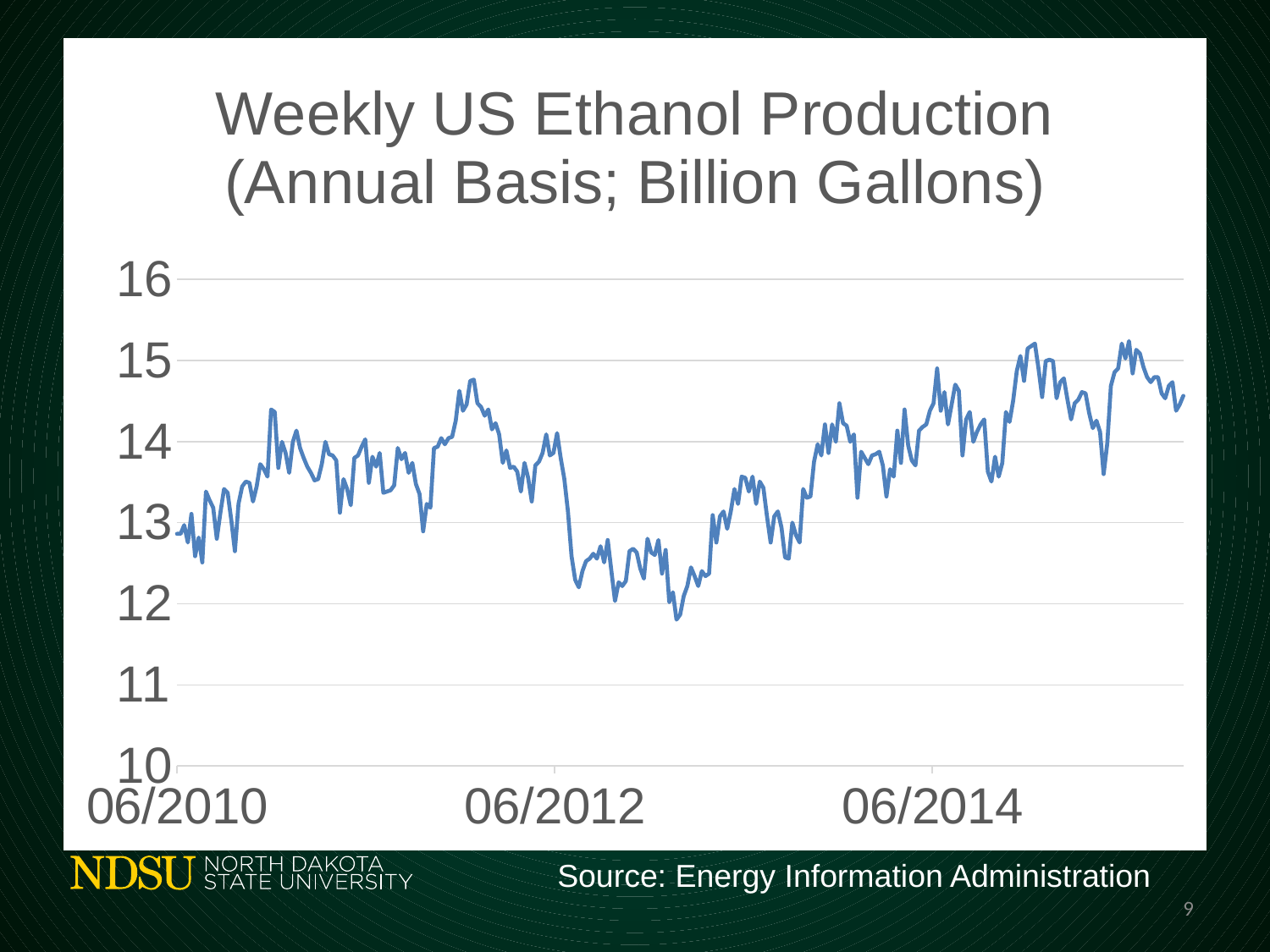
How many date labels are shown on the horizontal axis? 3 Does the line ever rise above 16 on the chart? No What are the lowest and highest values shown on the vertical axis? 10 and 16 What is the title of the chart? Weekly US Ethanol Production (Annual Basis; Billion Gallons) How many lines (series) are plotted on the chart? 1 What kind of chart is shown on the slide? line chart Is the highest point of the line greater or less than 15? greater Overall, is the value at the end of the series higher or lower than at the start (06/2010)? higher Does the line ever fall below 11 on the chart? No Which date label appears first on the horizontal axis? 06/2010